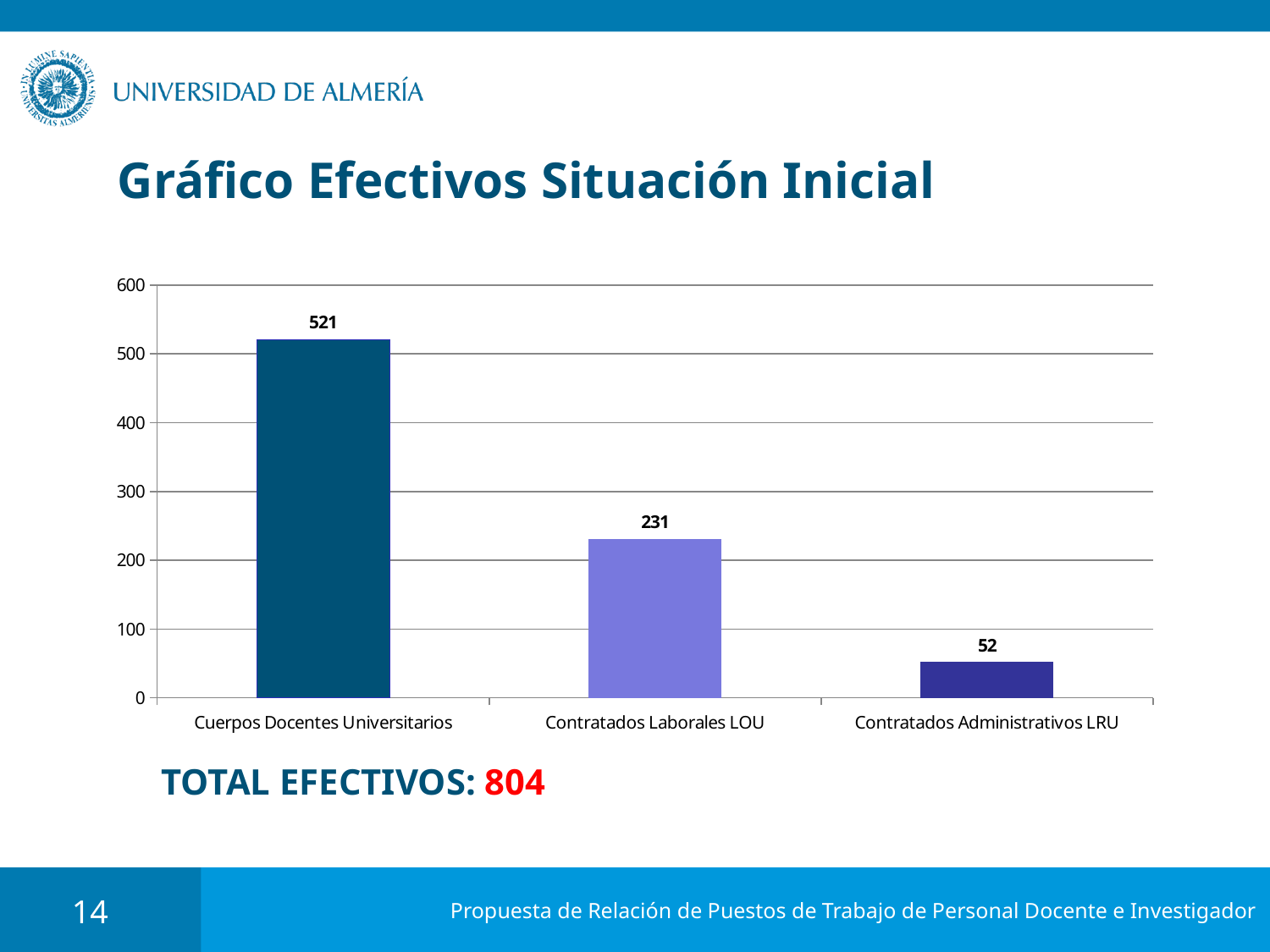
What is the title of the chart on the slide? Gráfico Efectivos Situación Inicial What is the difference between the values for Contratados Laborales LOU and Contratados Administrativos LRU? 179 How many categories are shown in the chart? 3 What kind of chart is shown on the slide? bar chart What is the value for Cuerpos Docentes Universitarios? 521 Which category has the lowest value? Contratados Administrativos LRU What is the value for Contratados Laborales LOU? 231 Which is larger, the value for Contratados Laborales LOU or Contratados Administrativos LRU? Contratados Laborales LOU Is the value for Contratados Laborales LOU greater or less than 300? less What is the difference between the values for Cuerpos Docentes Universitarios and Contratados Laborales LOU? 290 Which category has the highest value? Cuerpos Docentes Universitarios What is the value for Contratados Administrativos LRU? 52